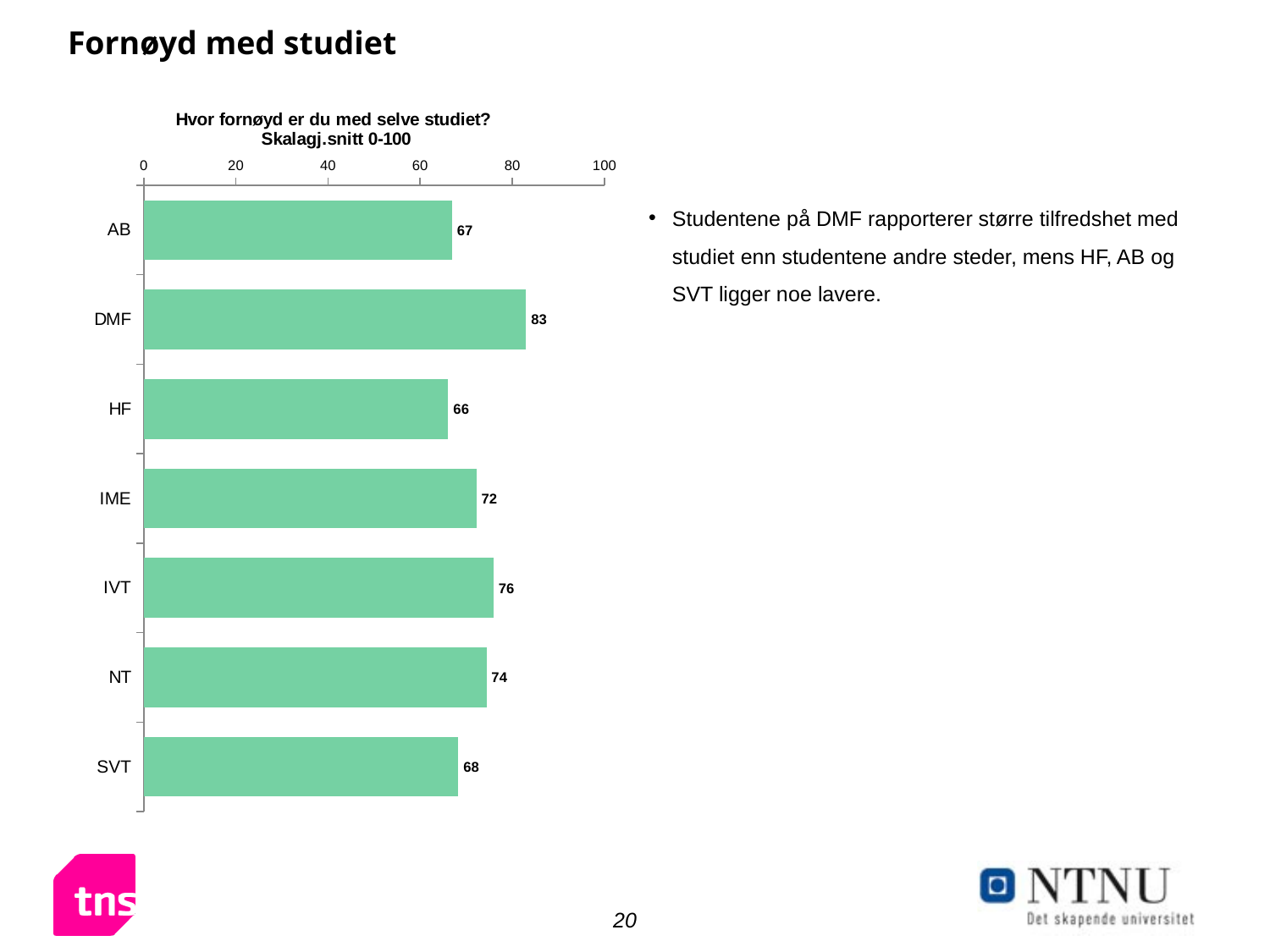
What is the value for IME? 72 What is the difference between the values for IVT and NT? 2 Which category has the highest value? DMF What is the value for SVT? 68 How many categories are shown in the chart? 7 What is the value for DMF? 83 Which is larger, the value for IVT or the value for IME? IVT Which category has the lowest value? HF What is the difference between the values for DMF and HF? 17 Is the value for DMF greater or less than 80? greater What kind of chart is shown on the slide? bar chart What is the title of the chart? Hvor fornøyd er du med selve studiet? Skalagj.snitt 0-100